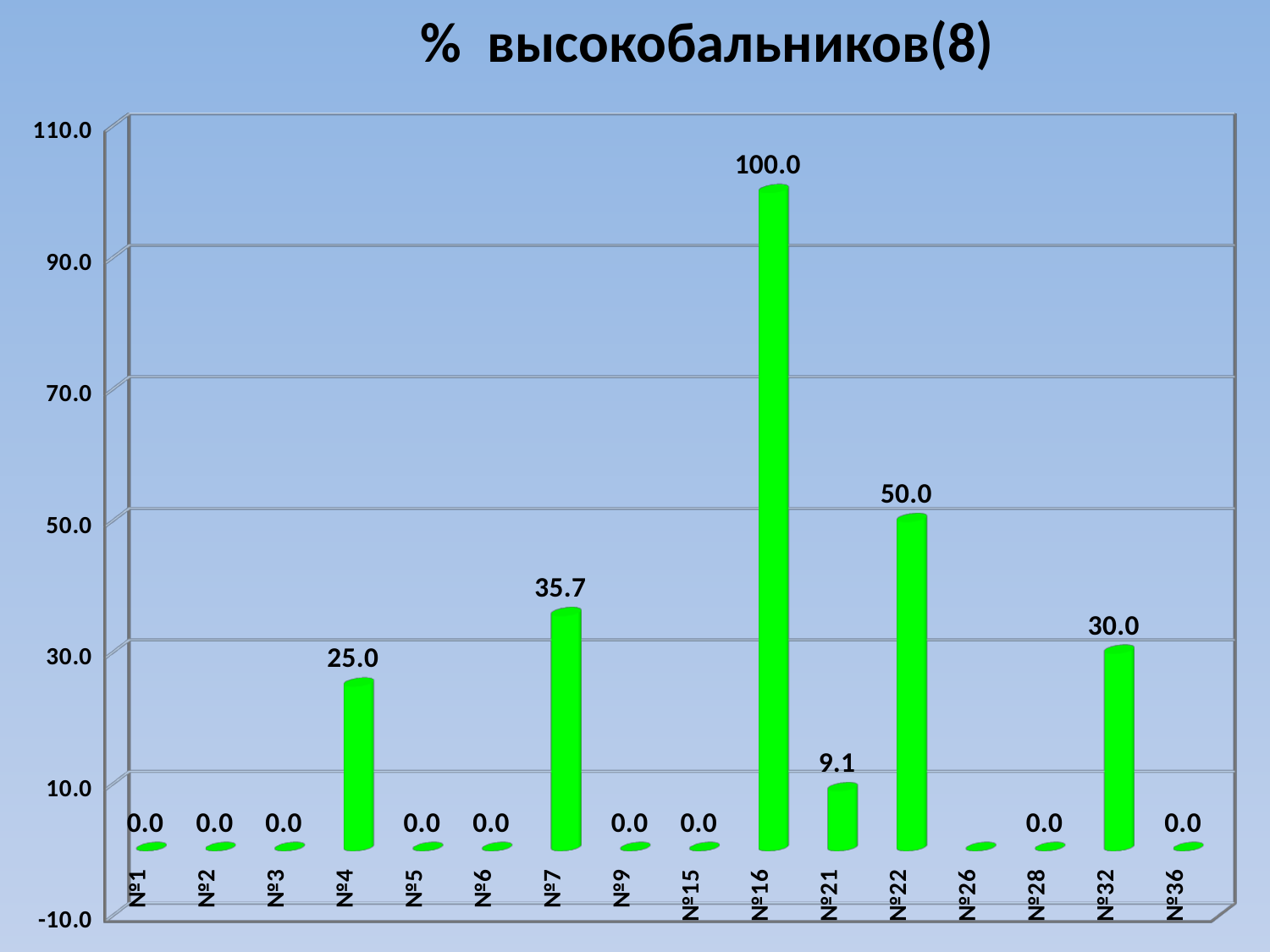
What is the title of the chart? % высокобальников(8) Which is larger, the value for №22 or the value for №32? №22 What is the value for №21? 9.1 What is the value for №4? 25.0 What kind of chart is shown on the slide? Bar chart What is the difference between the values for №16 and №22? 50.0 What is the value for №16? 100.0 Which category has the highest value? №16 What is the value for №7? 35.7 What is the difference between the values for №7 and №4? 10.7 How many categories are shown on the x axis? 16 What is the value for №32? 30.0